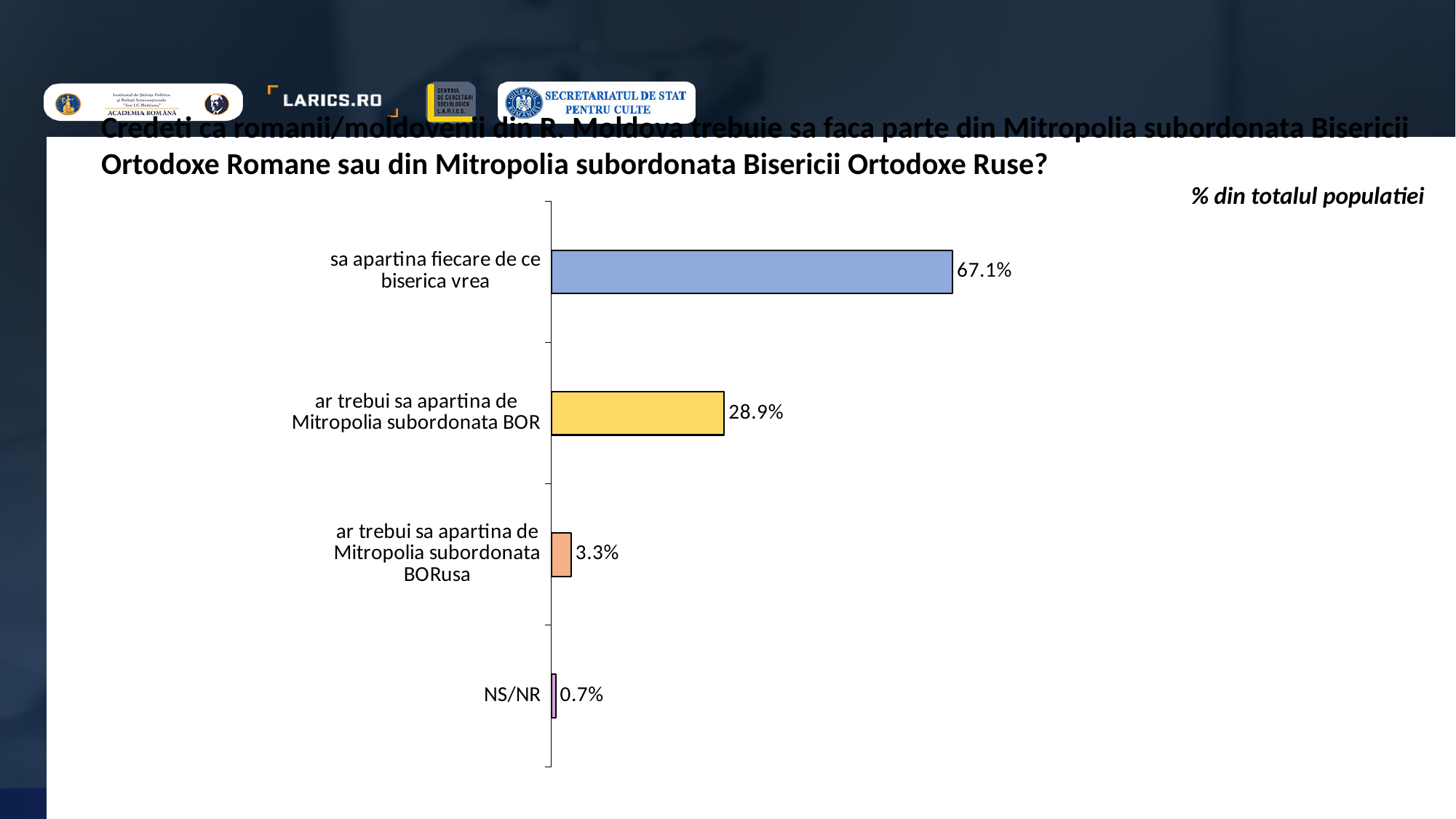
What is the difference between the values for "sa apartina fiecare de ce biserica vrea" and "ar trebui sa apartina de Mitropolia subordonata BOR"? 38.2% What is the difference between the values for "ar trebui sa apartina de Mitropolia subordonata BOR" and "ar trebui sa apartina de Mitropolia subordonata BORusa"? 25.6% What unit note is shown at the top right of the chart? % din totalul populatiei What is the value for "ar trebui sa apartina de Mitropolia subordonata BOR"? 28.9% What kind of chart is shown on the slide? bar chart Which is larger: the value for "ar trebui sa apartina de Mitropolia subordonata BOR" or for "ar trebui sa apartina de Mitropolia subordonata BORusa"? ar trebui sa apartina de Mitropolia subordonata BOR Which category has the highest value? sa apartina fiecare de ce biserica vrea What percentage of respondents chose "sa apartina fiecare de ce biserica vrea"? 67.1% What is the value for "ar trebui sa apartina de Mitropolia subordonata BORusa"? 3.3% How many categories are shown in the chart? 4 What is the value for NS/NR? 0.7% Which category has the lowest value? NS/NR